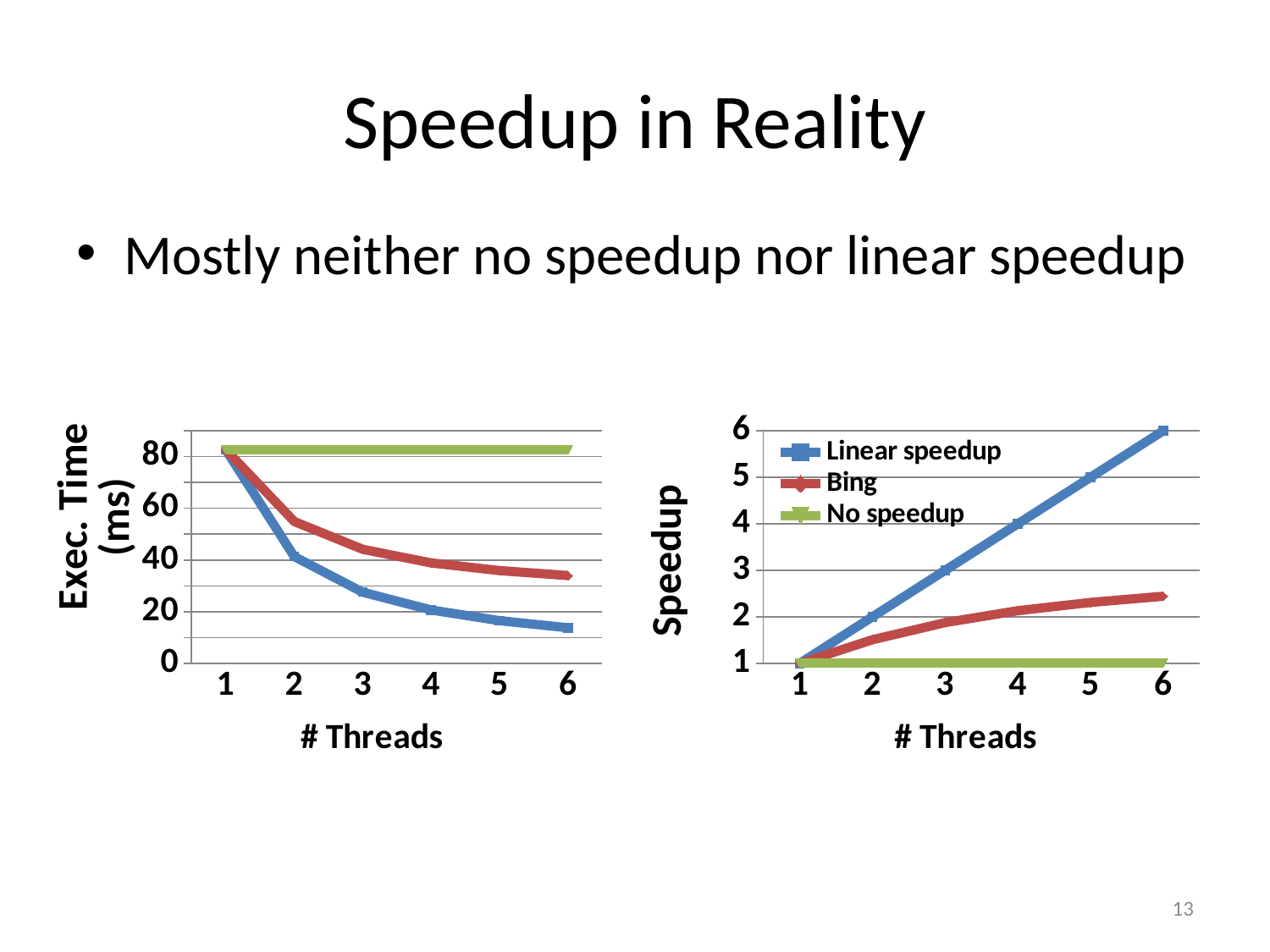
In the right-hand Speedup chart, is the Bing value at 6 threads greater or less than 3? less In the left-hand Exec. Time chart, does the red series rise or fall as the number of threads increases? fall In the left-hand Exec. Time chart, is the blue series value at 6 threads greater or less than 20? less How many thread counts are plotted along the x axis of the left-hand Exec. Time chart? 6 What type of chart is the right-hand chart (Speedup vs # Threads)? line chart How many series does the legend of the right-hand Speedup chart list? 3 In the right-hand Speedup chart, what is the Linear speedup value at 6 threads? 6 In the right-hand Speedup chart, what is the Linear speedup value at 3 threads? 3 In the right-hand Speedup chart, which series has the lowest value at 6 threads? No speedup In the right-hand Speedup chart, which series has the highest value at 6 threads? Linear speedup